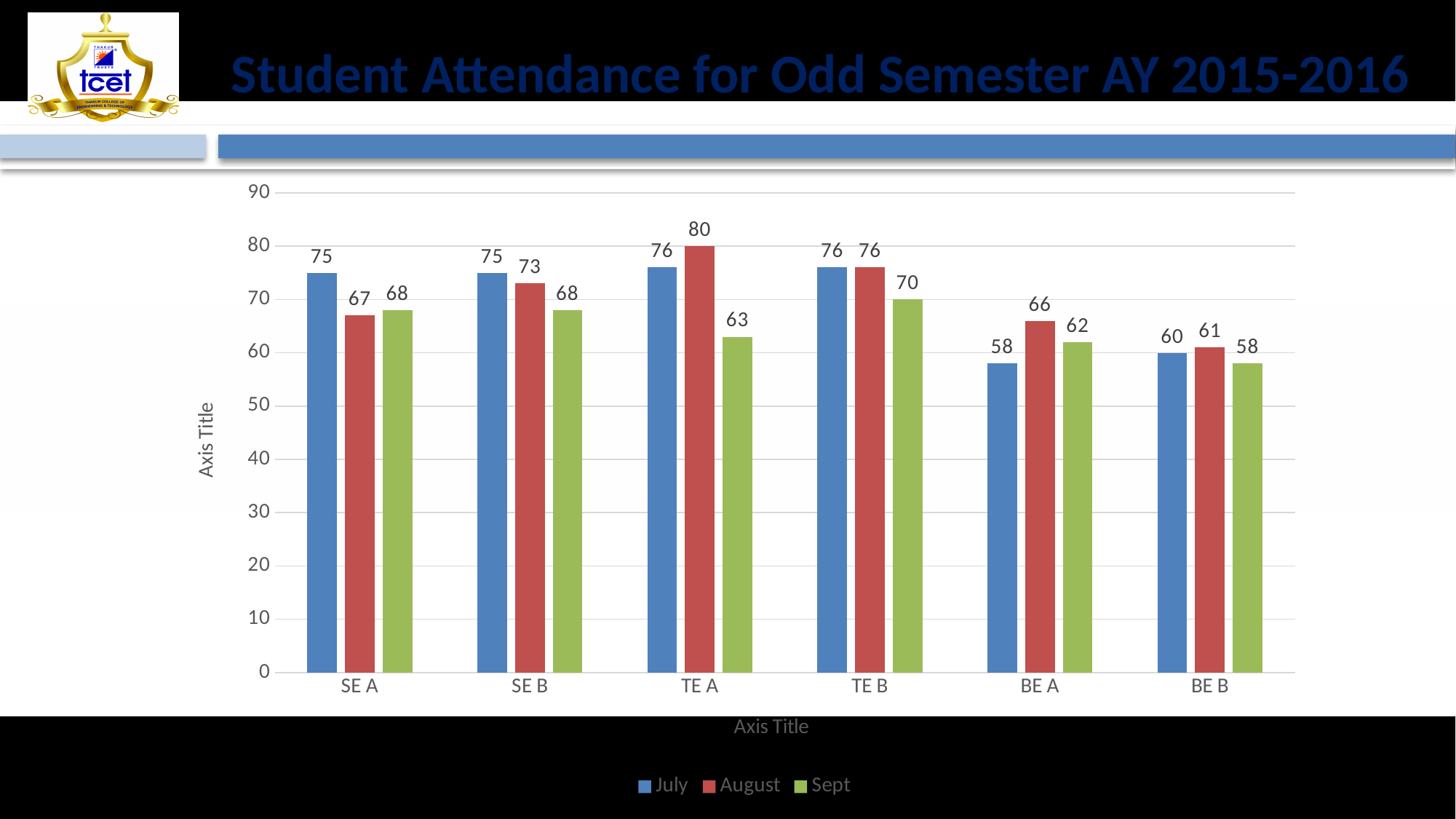
Which category has the highest August value? TE A How many series does the legend list? 3 What is the difference between the August and Sept values for TE A? 17 Which is larger for BE A: the July value or the August value? August What is the Sept attendance value for BE B? 58 Is the Sept value for TE B greater or less than 60? greater What is the August attendance value for TE A? 80 How many categories are shown on the x axis? 6 What kind of chart is shown on the slide? bar chart Which category has the lowest July value? BE A What is the July attendance value for SE A? 75 What are the series names listed in the legend? July, August, Sept